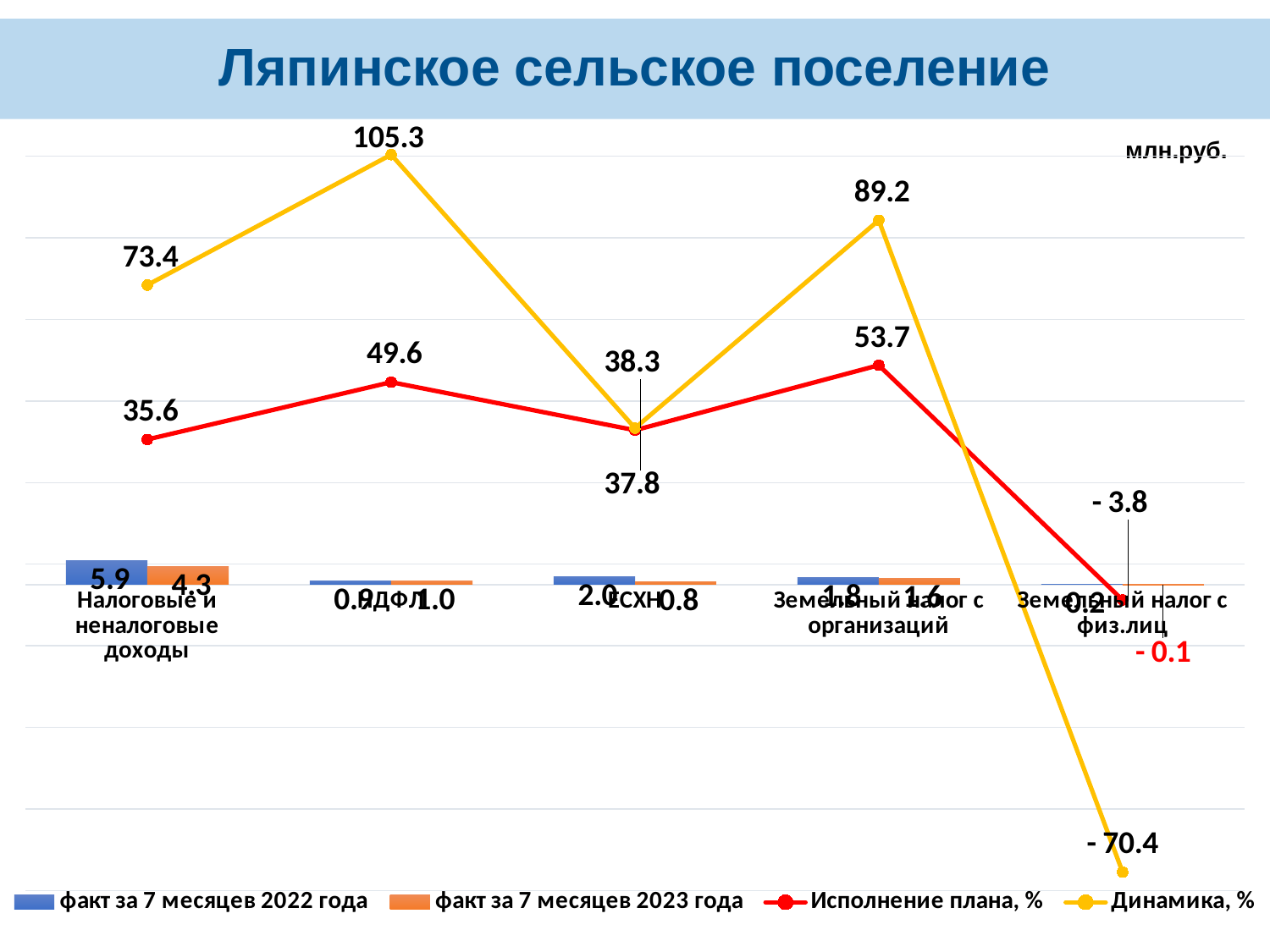
What is the value of Динамика, % for Земельный налог с физ.лиц? -70.4 Which category has the lowest value of Динамика, %? Земельный налог с физ.лиц What is the value of Динамика, % for НДФЛ? 105.3 Which category has the highest value of Исполнение плана, %? Земельный налог с организаций What is the value of факт за 7 месяцев 2022 года for Налоговые и неналоговые доходы? 5.9 What is the value of факт за 7 месяцев 2023 года for Налоговые и неналоговые доходы? 4.3 What is the title of the slide? Ляпинское сельское поселение Which category has the highest value of Динамика, %? НДФЛ Which is larger, Исполнение плана, % for НДФЛ or for Налоговые и неналоговые доходы? НДФЛ What is the difference between факт за 7 месяцев 2022 года and факт за 7 месяцев 2023 года for Налоговые и неналоговые доходы? 1.6 How many series does the legend list? 4 What is the value of Исполнение плана, % for Земельный налог с организаций? 53.7